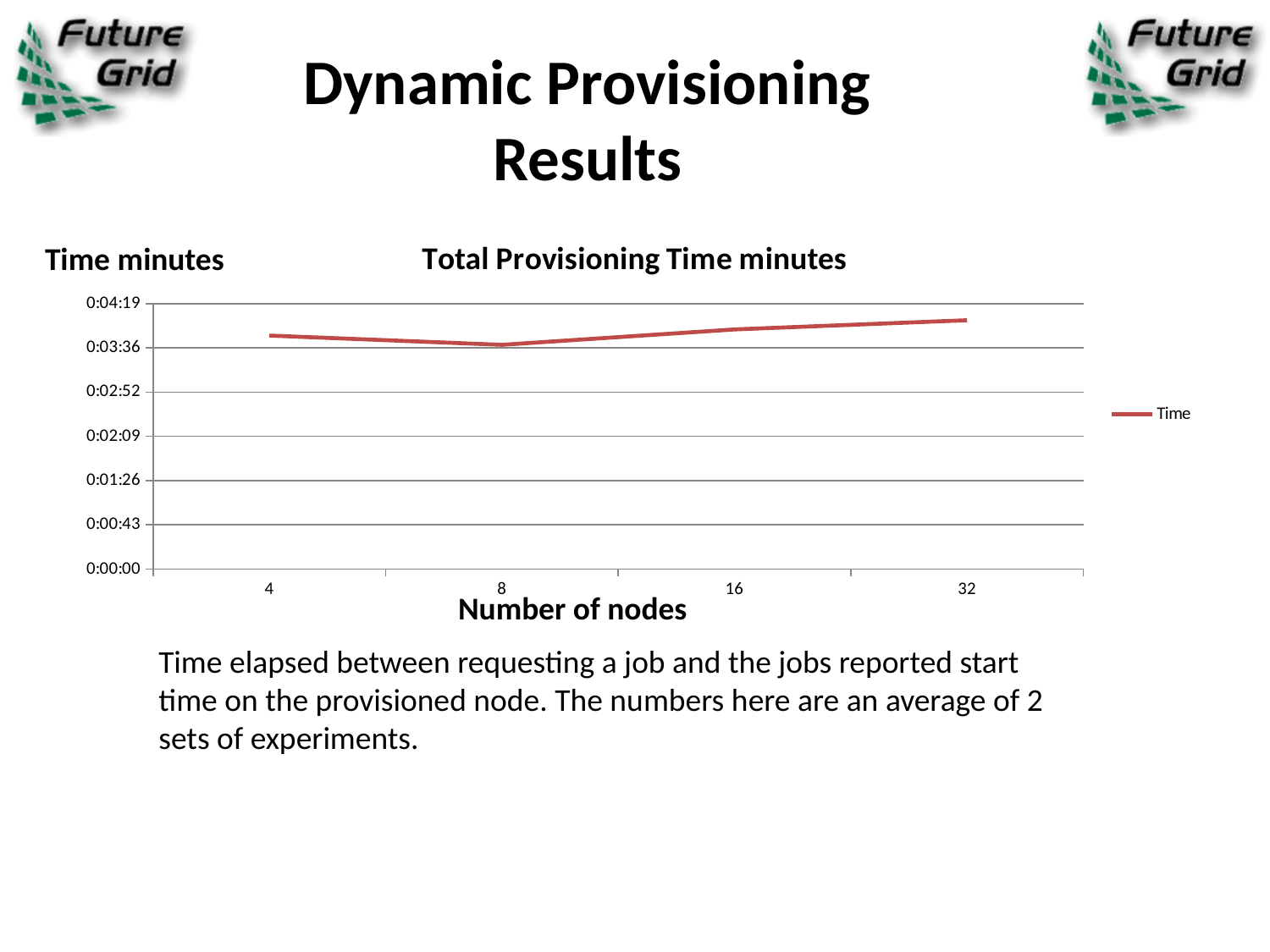
Is the provisioning time for 16 nodes greater or less than 0:04:19? less At which number of nodes is the provisioning time lowest? 8 Is the provisioning time for 4 nodes greater or less than 0:02:52? greater What kind of chart is shown on the slide? line chart How many node counts are plotted along the x axis? 4 Is the provisioning time for 32 nodes greater or less than 0:03:36? greater Does the provisioning time rise or fall from 8 nodes to 32 nodes? rise How many series does the legend list? 1 At which number of nodes is the provisioning time highest? 32 What is the name of the series in the legend? Time What is the title of the chart? Total Provisioning Time minutes Which has a larger provisioning time, 8 nodes or 32 nodes? 32 nodes